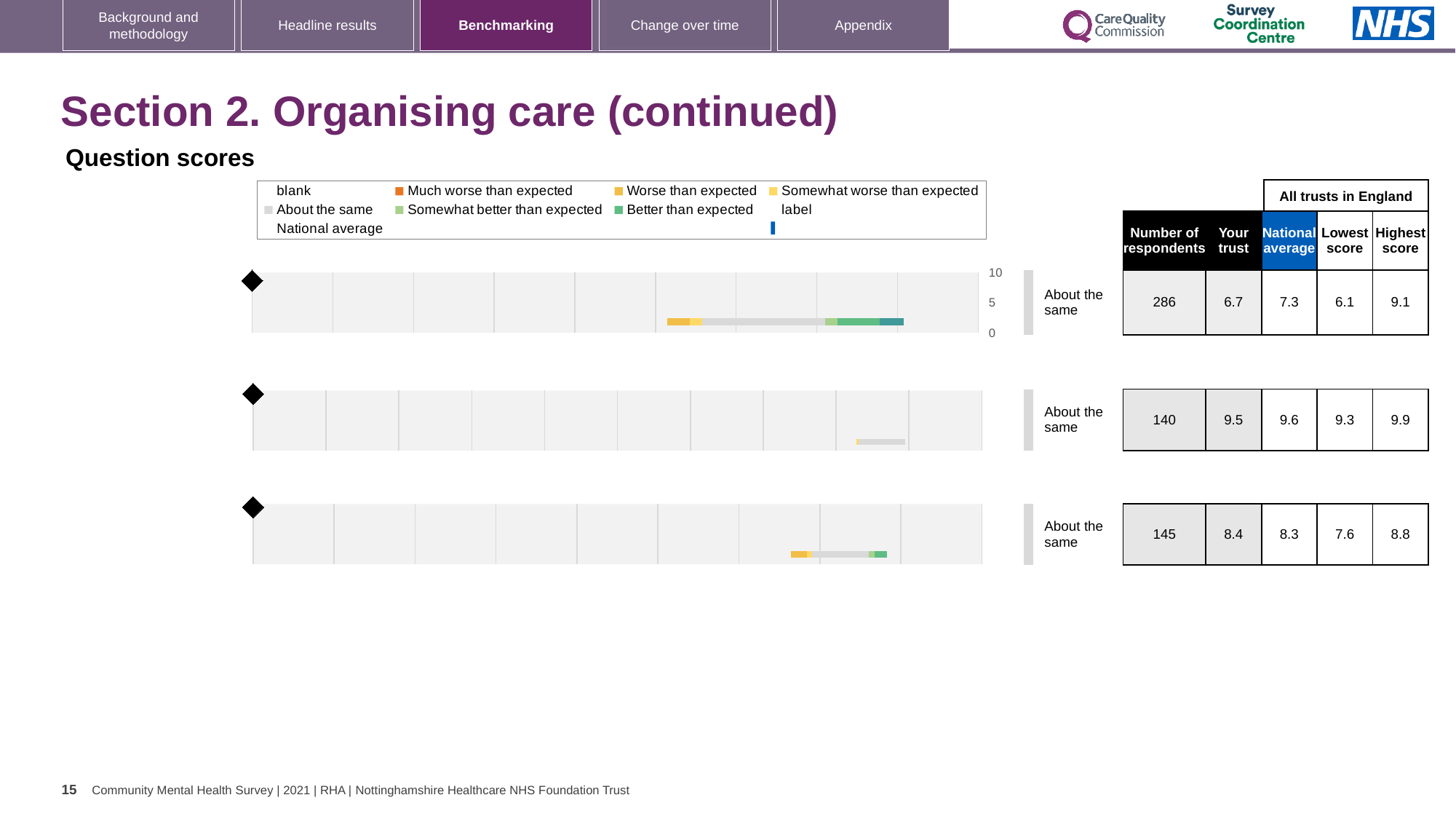
For the top chart's row, what is the difference between the highest score (9.1) and the lowest score (6.1)? 3.0 Which legend entry is shown in orange? Much worse than expected In the top chart's row of the table, what is the 'Your trust' score? 6.7 In the top chart's row of the table, what is the national average score? 7.3 How many question charts are shown on the slide? 3 Which chart row (top, middle or bottom) has the lowest 'Your trust' score? top What kind of chart is used for each question score on the slide? bar chart Which chart row (top, middle or bottom) has the highest 'Your trust' score? middle In the middle chart's row of the table, how many respondents are there? 140 For the bottom chart's row, which is larger: the 'Your trust' score or the national average? Your trust In the bottom chart's row of the table, what is the highest score among all trusts in England? 8.8 In the middle chart's row of the table, what is the lowest score among all trusts in England? 9.3